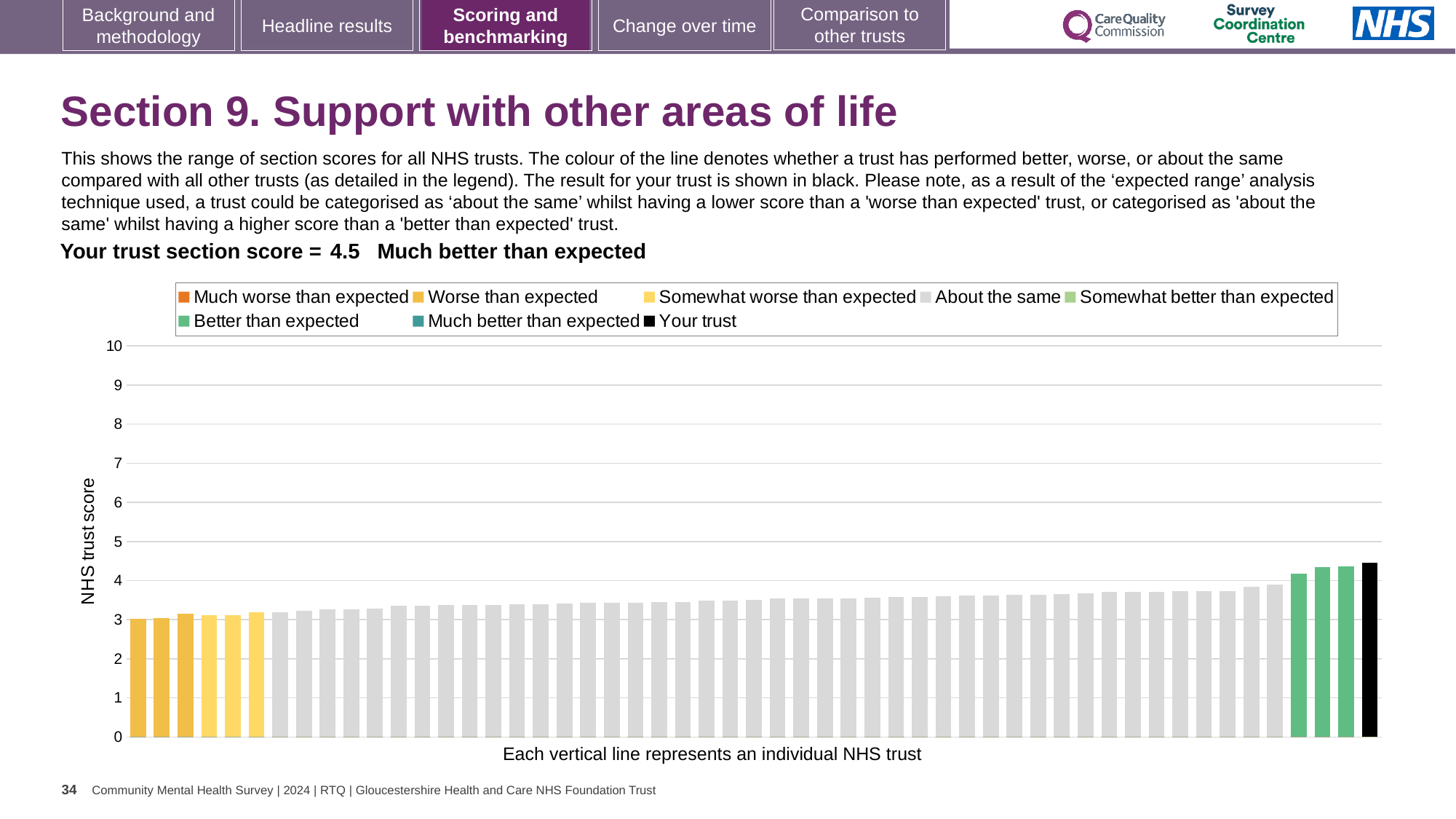
Which bar is the highest on the chart? Your trust (the black bar) Is the value of the highest grey 'About the same' bar greater or less than 5? less Do the bar values rise or fall from left to right along the x axis? rise What is the section score for your trust shown on the chart? 4.5 What is the label on the vertical axis of the chart? NHS trust score Is the value for your trust greater or less than 4? greater Which performance category is your trust's section score assigned to? Much better than expected Is the value of the leftmost (lowest) bar greater or less than 2? greater According to the x-axis caption, what does each vertical line represent? An individual NHS trust Is your trust's bar higher or lower than the leftmost bar? higher What kind of chart is shown on the slide? bar chart How many entries does the chart legend list? 8